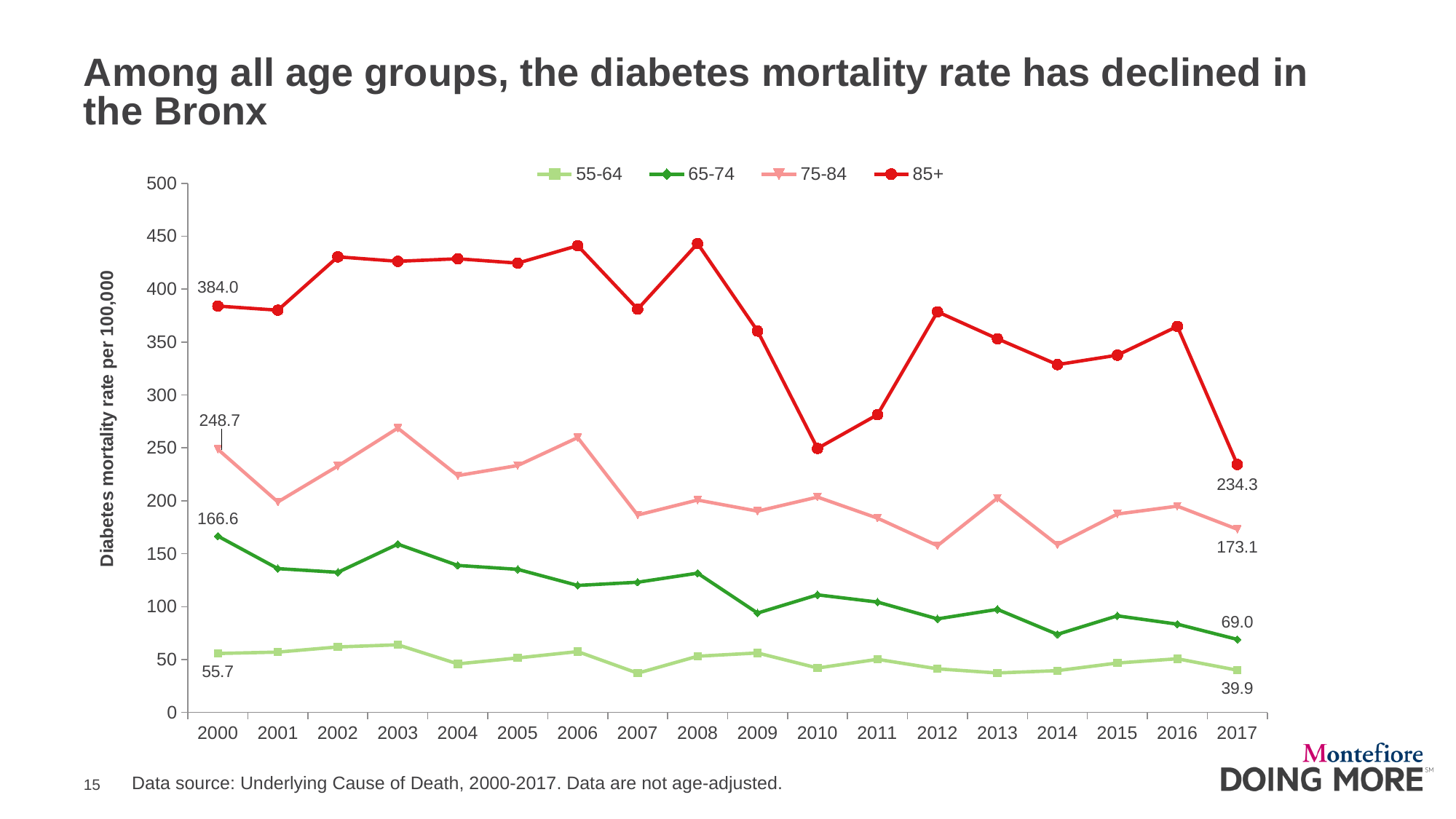
How many years are plotted along the x axis? 18 Which age group had the highest diabetes mortality rate in 2017? 85+ What was the diabetes mortality rate for the 55-64 age group in 2017? 39.9 Is the value for the 85+ age group in 2010 greater or less than 300? less What type of chart is shown on the slide? line chart What was the diabetes mortality rate for the 85+ age group in 2000? 384.0 How many series does the legend list? 4 By how much did the diabetes mortality rate for the 85+ age group fall from 2000 to 2017? 149.7 What was the diabetes mortality rate for the 75-84 age group in 2000? 248.7 What was the diabetes mortality rate for the 85+ age group in 2017? 234.3 What was the diabetes mortality rate for the 65-74 age group in 2017? 69.0 What is the title of the y axis? Diabetes mortality rate per 100,000